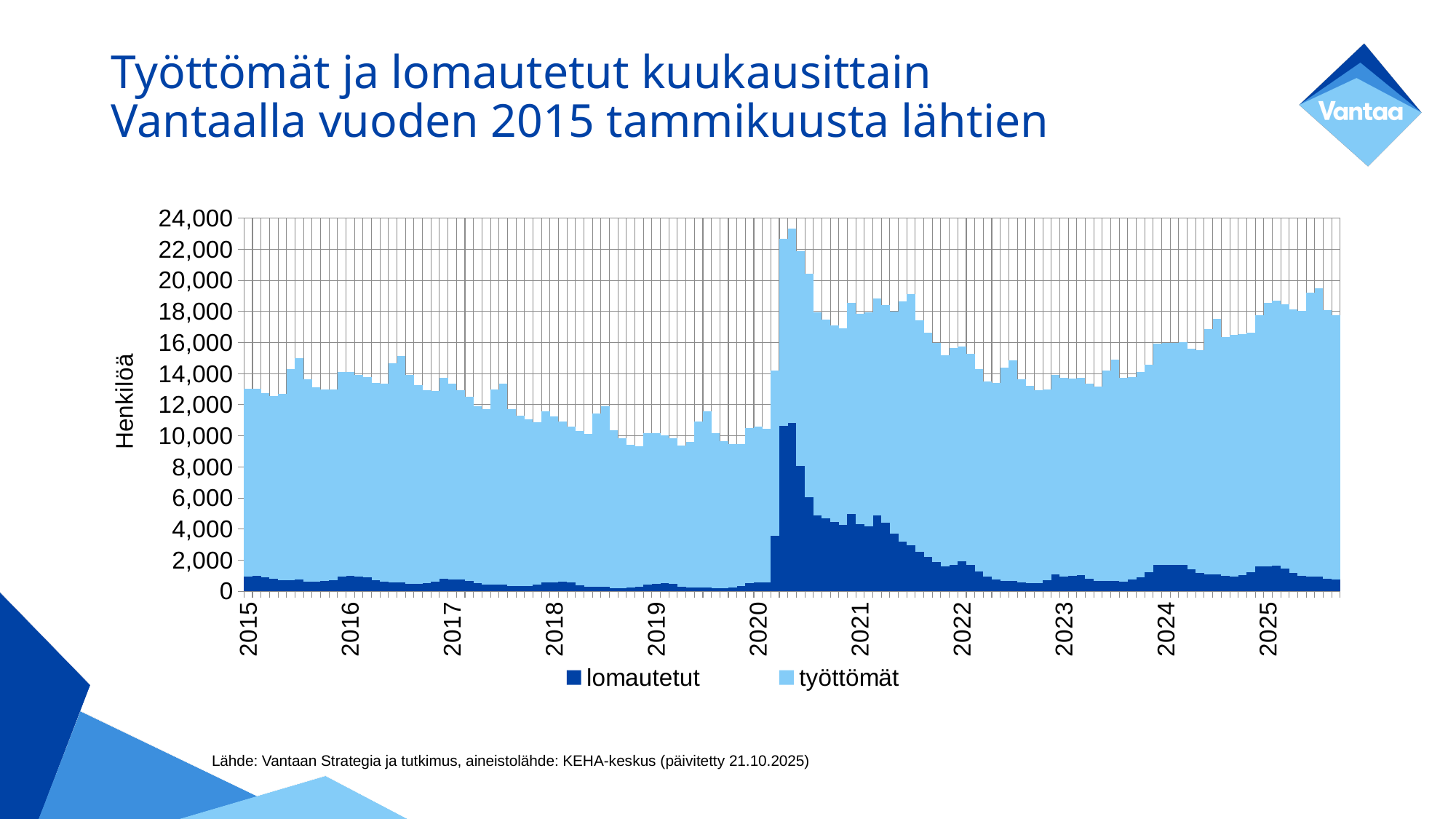
Does the total of the stacked bars rise or fall from 2015 to 2019? fall Which series is larger at the start of 2015, lomautetut or työttömät? työttömät Is the total of the stacked bar at the start of 2015 greater or less than 12,000? greater In which year does the total of the stacked bars reach its highest peak? 2020 Is the total of the stacked bar at the start of 2020 greater or less than 12,000? less Is the highest total of the stacked bars, reached in 2020, greater or less than 22,000? greater What kind of chart is shown on the slide? stacked bar chart What are the two series named in the legend? lomautetut and työttömät What is the label on the vertical axis? Henkilöä How many series does the legend list? 2 Does the total of the stacked bars rise or fall from 2023 to 2025? rise